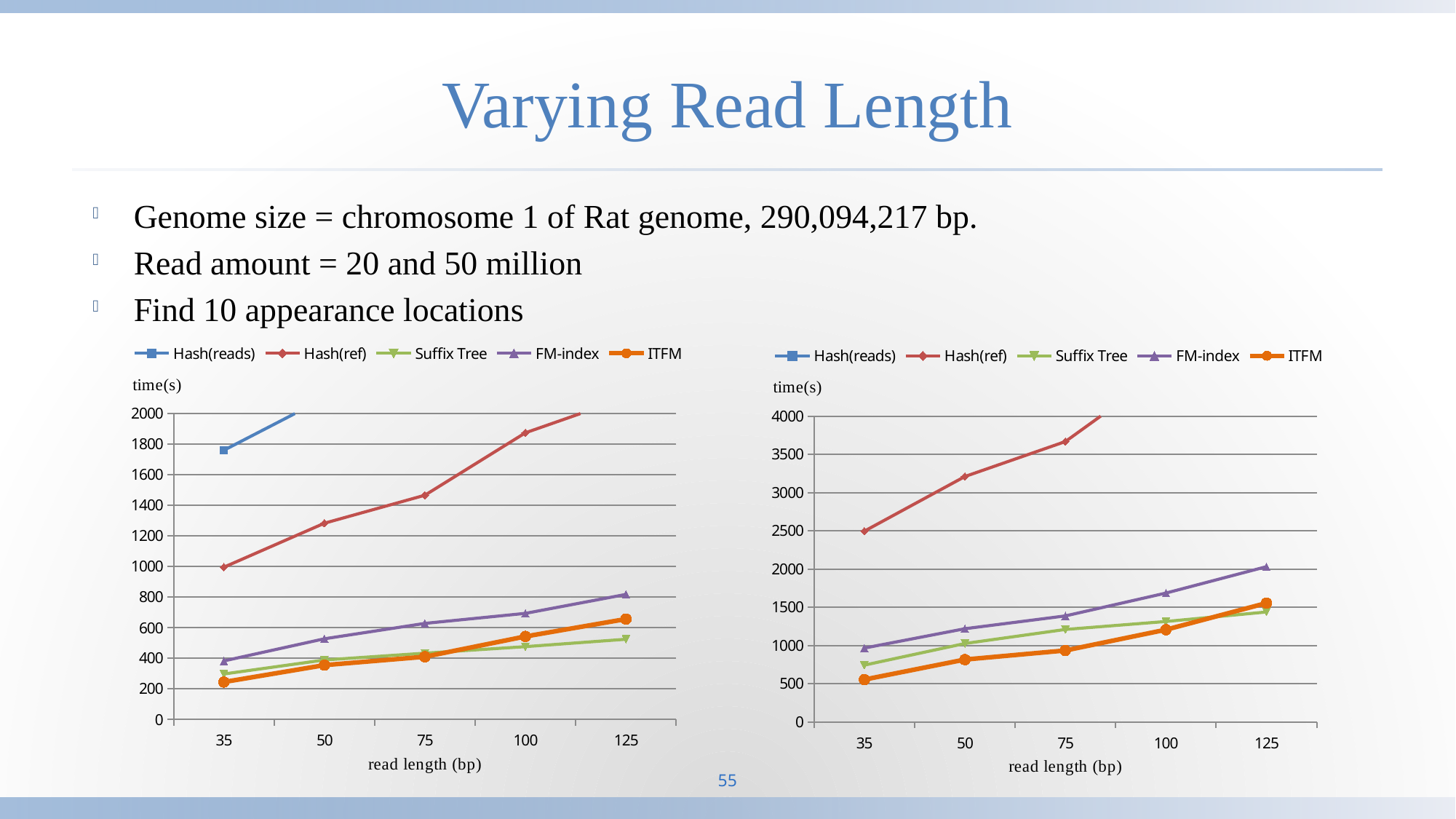
In the right chart, is the value for Suffix Tree at read length 35 greater or less than 1000? less In the left chart, is the value for Hash(ref) at read length 100 greater or less than 1800? greater In the left chart, does the ITFM line rise or fall as read length increases? rises What is the x-axis label of the right chart? read length (bp) How many series does the legend of the right chart list? 5 In the right chart, which series has the lowest value at read length 35? ITFM In the right chart, which is larger at read length 100: Suffix Tree or ITFM? Suffix Tree How many read length values are shown on the x axis of the left chart? 5 In the left chart, which is larger at read length 125: FM-index or ITFM? FM-index In the left chart, is the value for Suffix Tree at read length 125 greater or less than 600? less What kind of chart is the left chart on the slide? line chart